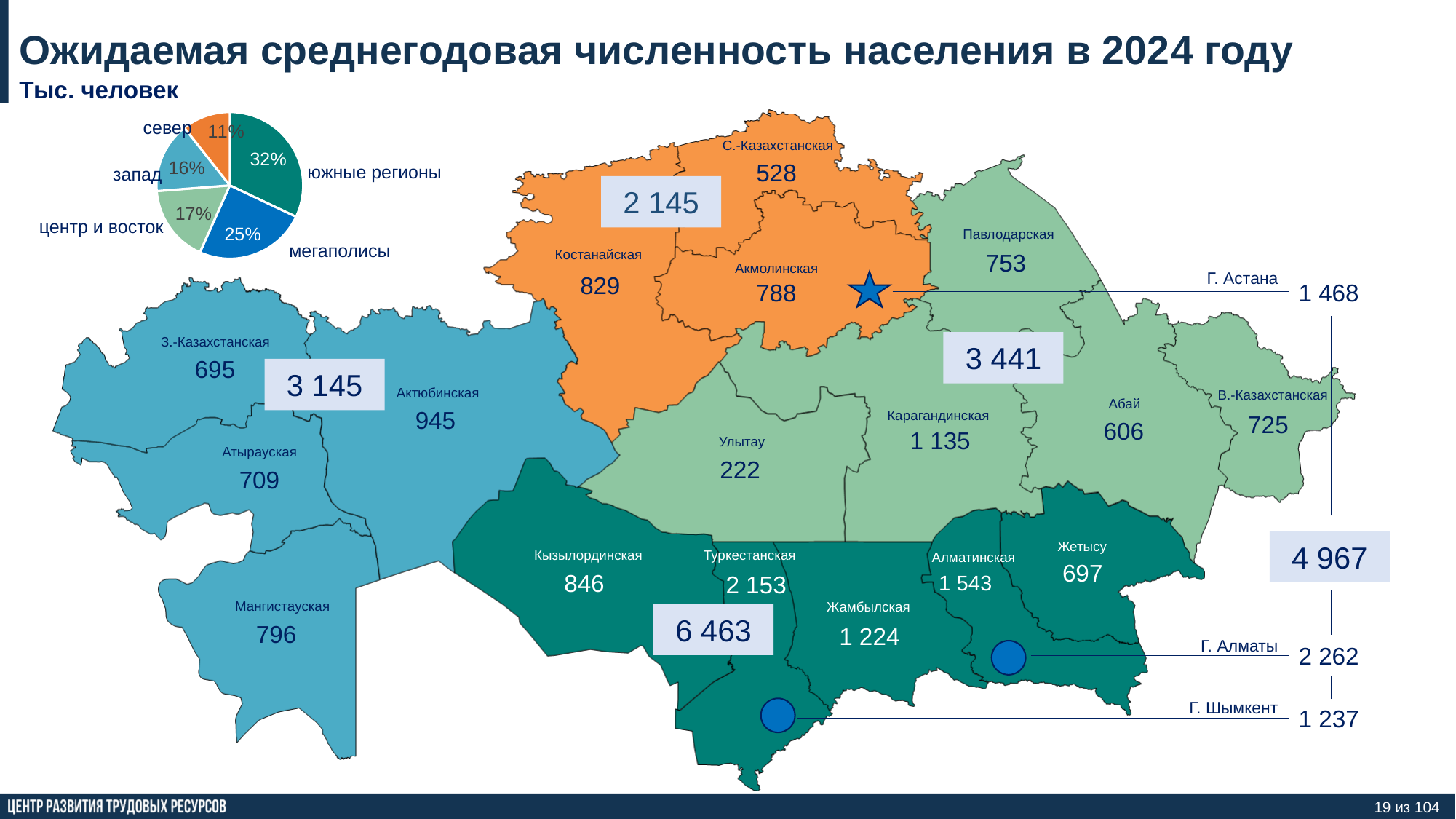
In the pie chart, what share is shown for мегаполисы? 25% On the map, what value is shown for Туркестанская? 2 153 On the map, what value is shown for Г. Алматы? 2 262 In the pie chart, which is larger: the share for запад or the share for центр и восток? центр и восток In the pie chart, what share is shown for север? 11% In the pie chart, what share is shown for запад? 16% In the pie chart, what is the difference in percentage points between южные регионы and центр и восток? 15 How many slices does the pie chart have? 5 In the pie chart, what share is shown for южные регионы? 32% Which slice of the pie chart is the smallest? север Which slice of the pie chart is the largest? южные регионы What kind of chart is shown in the top-left of the slide? pie chart